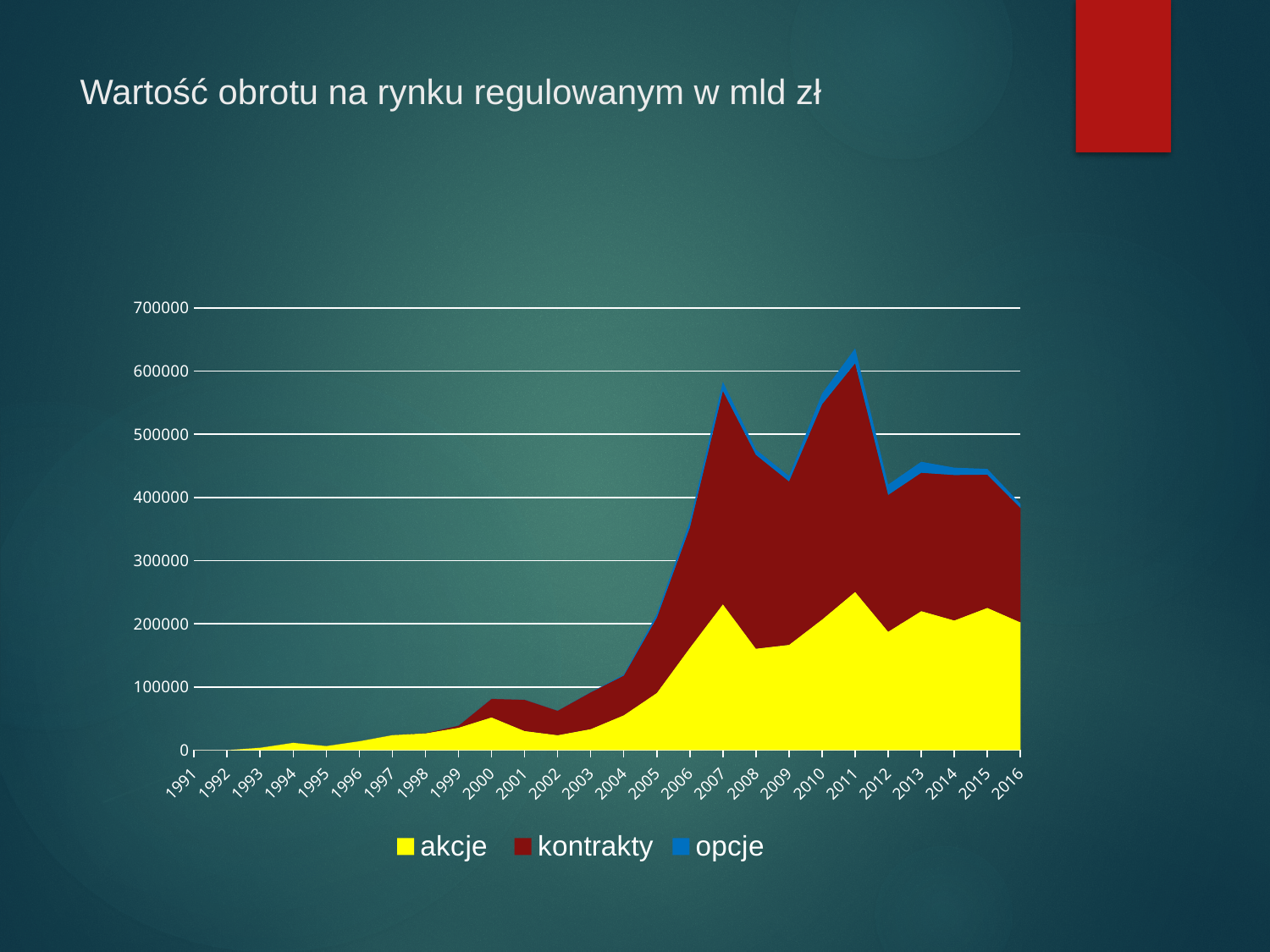
How many series does the legend list? 3 Do the total stacked values generally rise or fall from 1991 to 2007? rise Is the total stacked value for 2009 greater or less than 500000? less What kind of chart is shown on the slide? area chart In which year is the total stacked value lowest? 1991 Which series is shown in yellow? akcje Which year has the larger total stacked value, 2010 or 2009? 2010 What is the title of the chart? Wartość obrotu na rynku regulowanym w mld zł In which year is the total stacked value highest? 2011 Is the value for akcje in 2007 greater or less than 200000? greater How many years are shown on the x axis? 26 Is the total stacked value for 2011 greater or less than 600000? greater